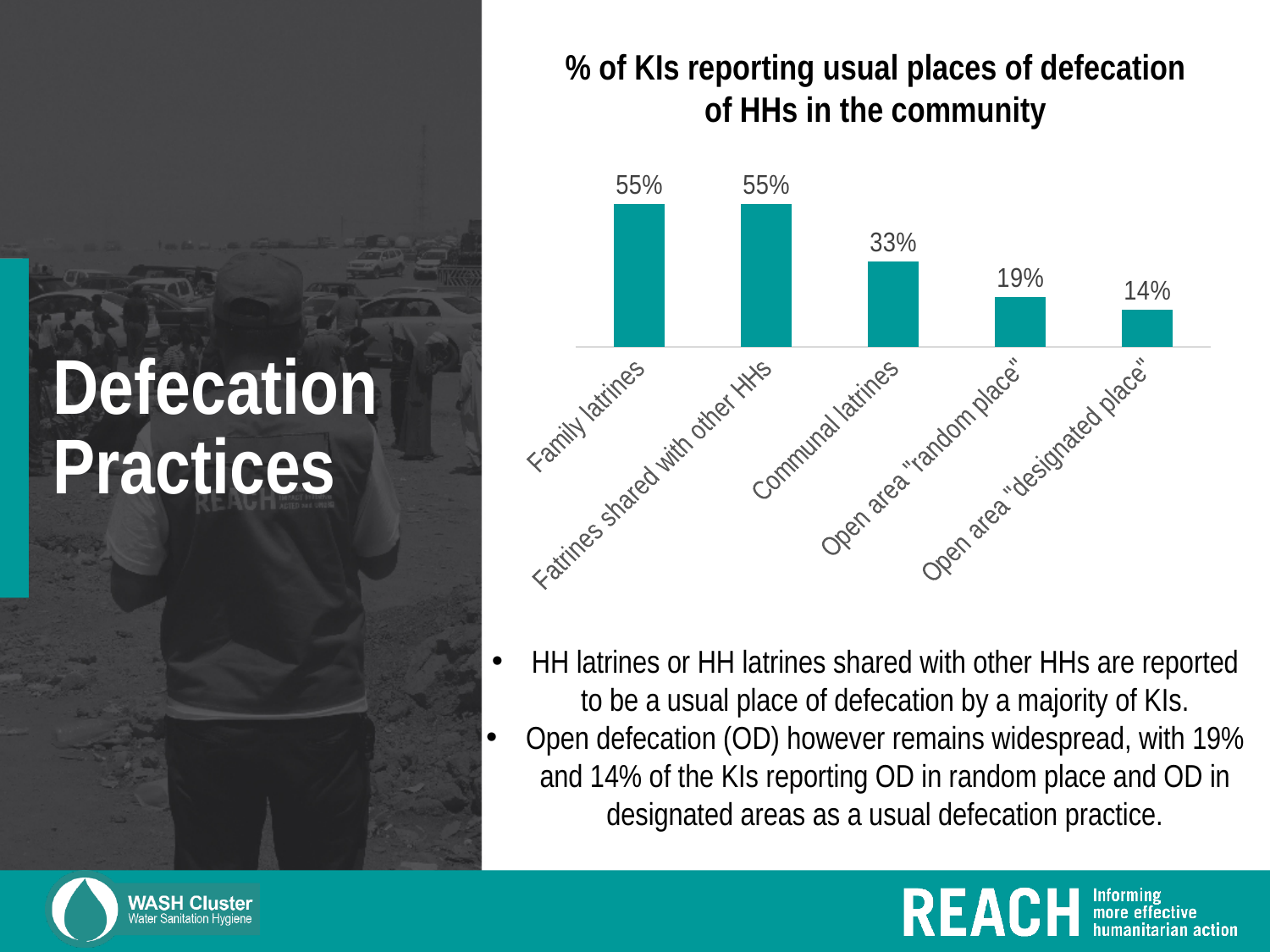
Which is larger, the value for communal latrines or the value for open area "random place"? Communal latrines What is the value for open area "designated place"? 14% Do the values rise or fall from left to right across the categories? Fall What is the difference between the values for family latrines and open area "designated place"? 41% How many categories are shown in the chart? 5 What is the difference between the values for communal latrines and open area "random place"? 14% What percentage of KIs reported open area "random place"? 19% What kind of chart is shown on the slide? Bar chart What is the value for communal latrines? 33% What is the title of the chart? % of KIs reporting usual places of defecation of HHs in the community Which category has the lowest value? Open area "designated place" What percentage of KIs reported family latrines as a usual place of defecation? 55%